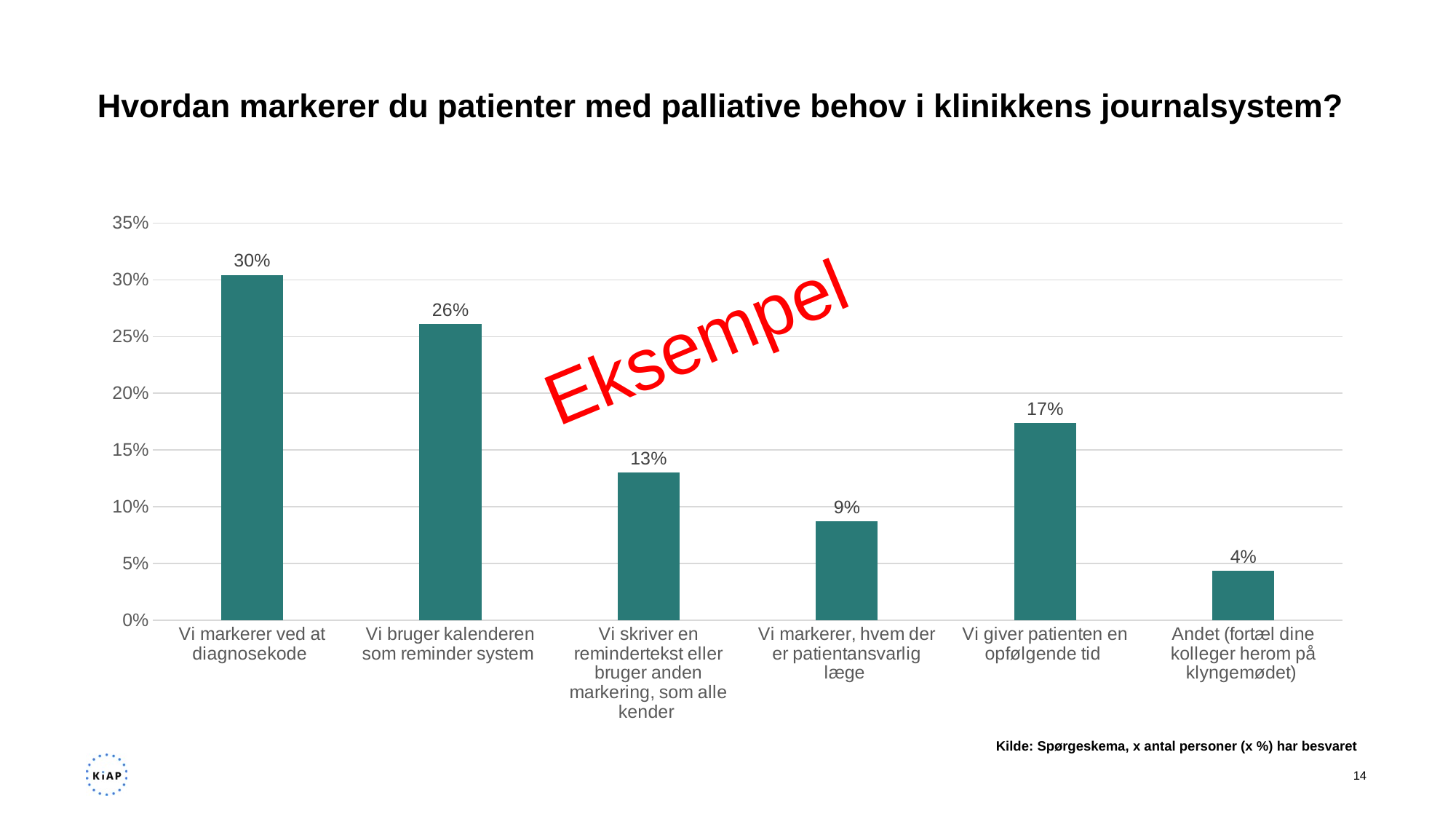
What is the value for "Vi markerer ved at diagnosekode"? 30% Is the value for "Vi markerer, hvem der er patientansvarlig læge" greater or less than 10%? less Which category has the lowest value? Andet (fortæl dine kolleger herom på klyngemødet) What is the value for "Vi bruger kalenderen som reminder system"? 26% What is the title of the chart? Hvordan markerer du patienter med palliative behov i klinikkens journalsystem? What is the value for "Andet (fortæl dine kolleger herom på klyngemødet)"? 4% Which is larger: the value for "Vi skriver en remindertekst eller bruger anden markering, som alle kender" or the value for "Vi giver patienten en opfølgende tid"? Vi giver patienten en opfølgende tid How many categories are shown in the chart? 6 What kind of chart is shown on the slide? bar chart What is the value for "Vi giver patienten en opfølgende tid"? 17% What is the difference between the values for "Vi markerer ved at diagnosekode" and "Vi bruger kalenderen som reminder system"? 4% Which category has the highest value? Vi markerer ved at diagnosekode